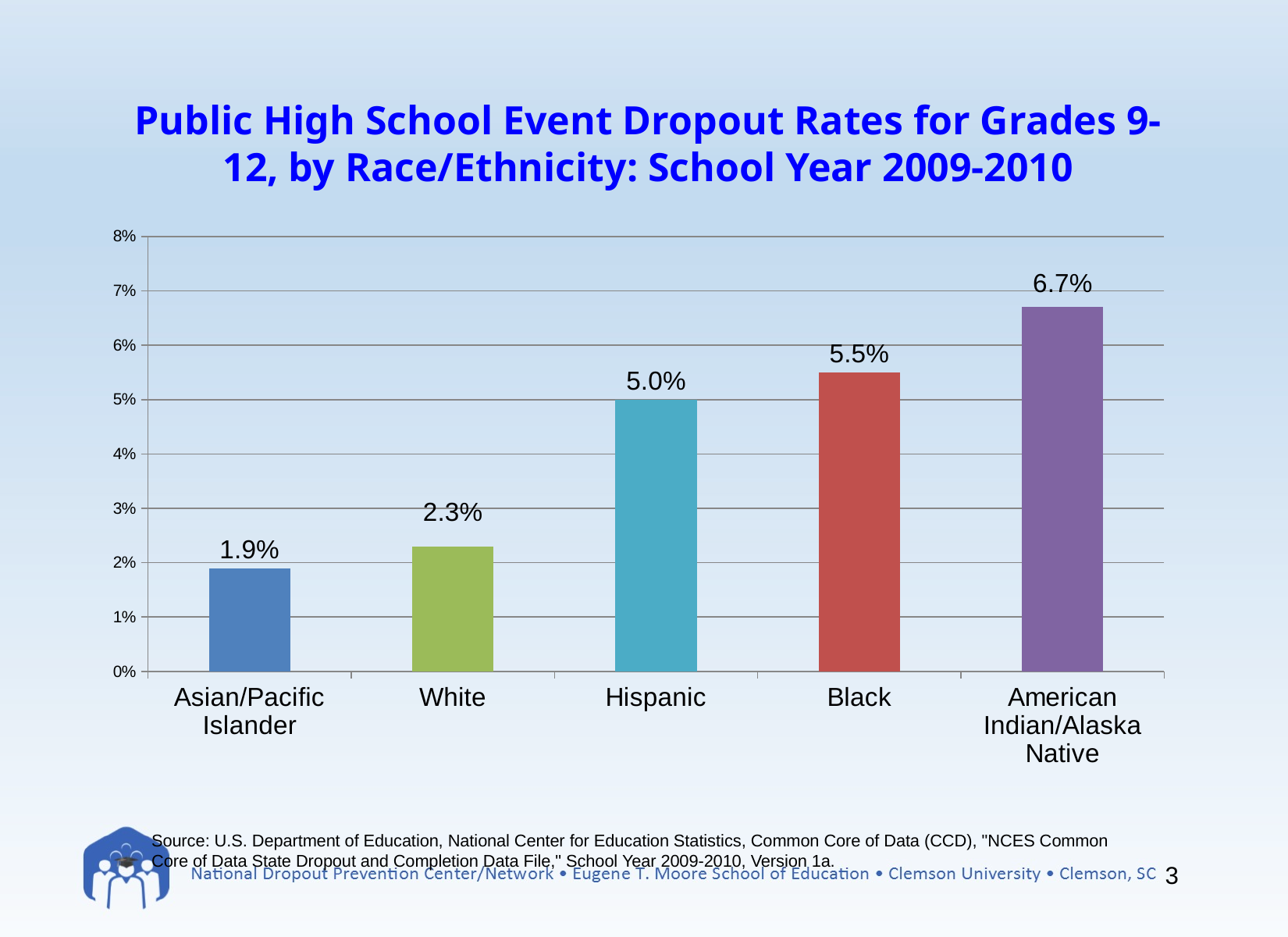
How many race/ethnicity categories are shown in the chart? 5 Do the dropout rates rise or fall moving from left to right across the categories? Rise Which race/ethnicity group has the highest dropout rate? American Indian/Alaska Native What is the difference between the dropout rates for Hispanic and White students? 2.7% What is the dropout rate for Hispanic students? 5.0% What is the difference between the dropout rates for American Indian/Alaska Native and Black students? 1.2% What kind of chart is shown on the slide? Bar chart Is the dropout rate for Black students greater or less than 5%? greater Which race/ethnicity group has the lowest dropout rate? Asian/Pacific Islander What is the dropout rate for Asian/Pacific Islander students? 1.9% Which group has a higher dropout rate, Black or Hispanic? Black What is the dropout rate for White students? 2.3%